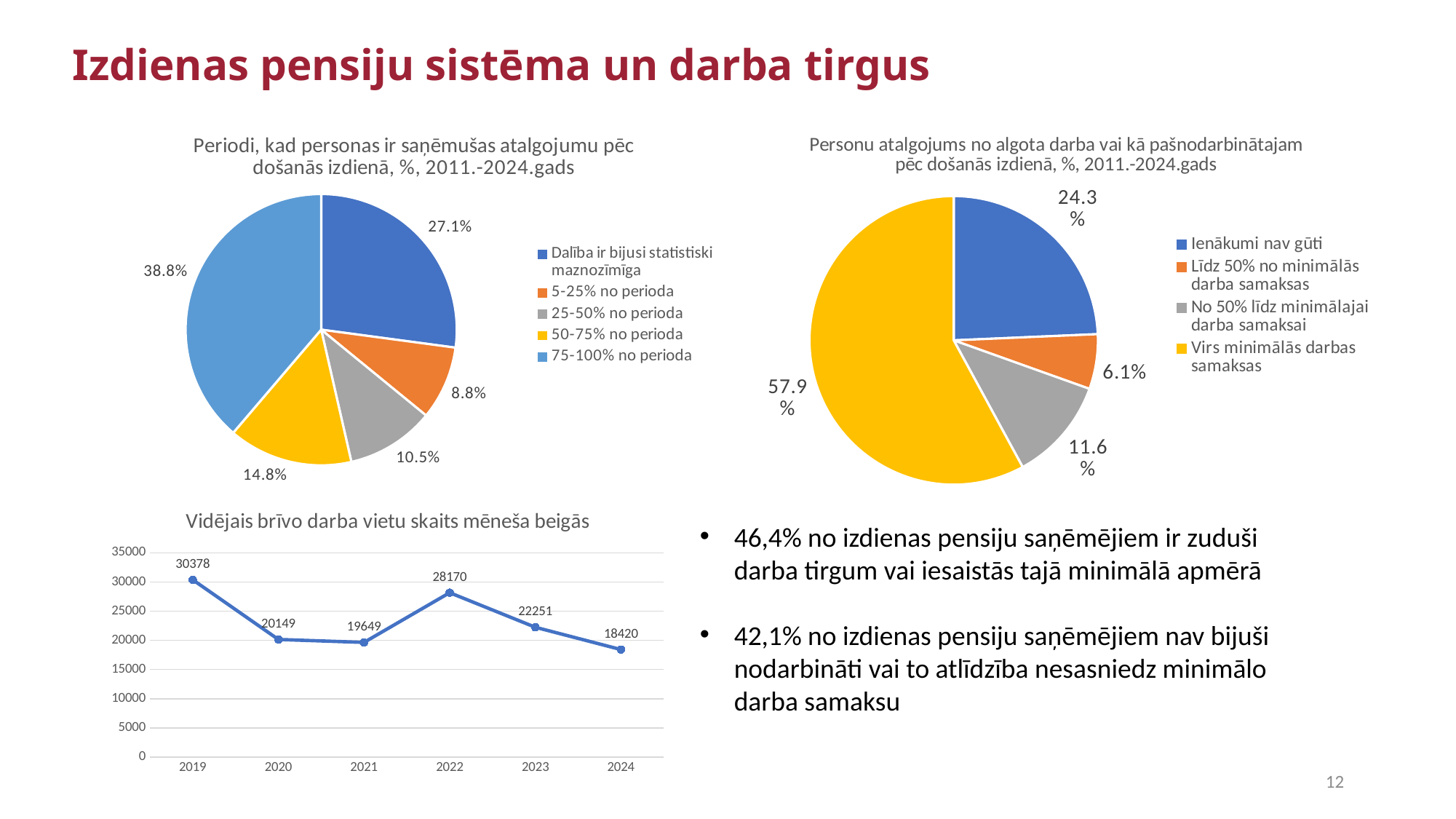
In the pie chart 'Periodi, kad personas ir saņēmušas atalgojumu pēc došanās izdienā', what is the value for '5-25% no perioda'? 8.8% In the chart 'Vidējais brīvo darba vietu skaits mēneša beigās', what is the difference between the values for 2019 and 2024? 11958 In the chart 'Vidējais brīvo darba vietu skaits mēneša beigās', is the value for 2023 larger than the value for 2021? Yes In the chart 'Vidējais brīvo darba vietu skaits mēneša beigās', which year has the highest value? 2019 In the pie chart 'Periodi, kad personas ir saņēmušas atalgojumu pēc došanās izdienā', what share does '75-100% no perioda' have? 38.8% In the chart 'Vidējais brīvo darba vietu skaits mēneša beigās', what is the value for 2022? 28170 In the pie chart 'Periodi, kad personas ir saņēmušas atalgojumu pēc došanās izdienā', which category has the smallest share? 5-25% no perioda What kind of chart is 'Vidējais brīvo darba vietu skaits mēneša beigās'? line chart In the pie chart 'Personu atalgojums no algota darba vai kā pašnodarbinātajam pēc došanās izdienā', what is the value for 'Ienākumi nav gūti'? 24.3% In the pie chart 'Periodi, kad personas ir saņēmušas atalgojumu pēc došanās izdienā', how many categories does the legend list? 5 In the pie chart 'Personu atalgojums no algota darba vai kā pašnodarbinātajam pēc došanās izdienā', what share does 'Virs minimālās darbas samaksas' have? 57.9% In the pie chart 'Personu atalgojums no algota darba vai kā pašnodarbinātajam pēc došanās izdienā', what is the difference between 'No 50% līdz minimālajai darba samaksai' and 'Līdz 50% no minimālās darba samaksas'? 5.5%